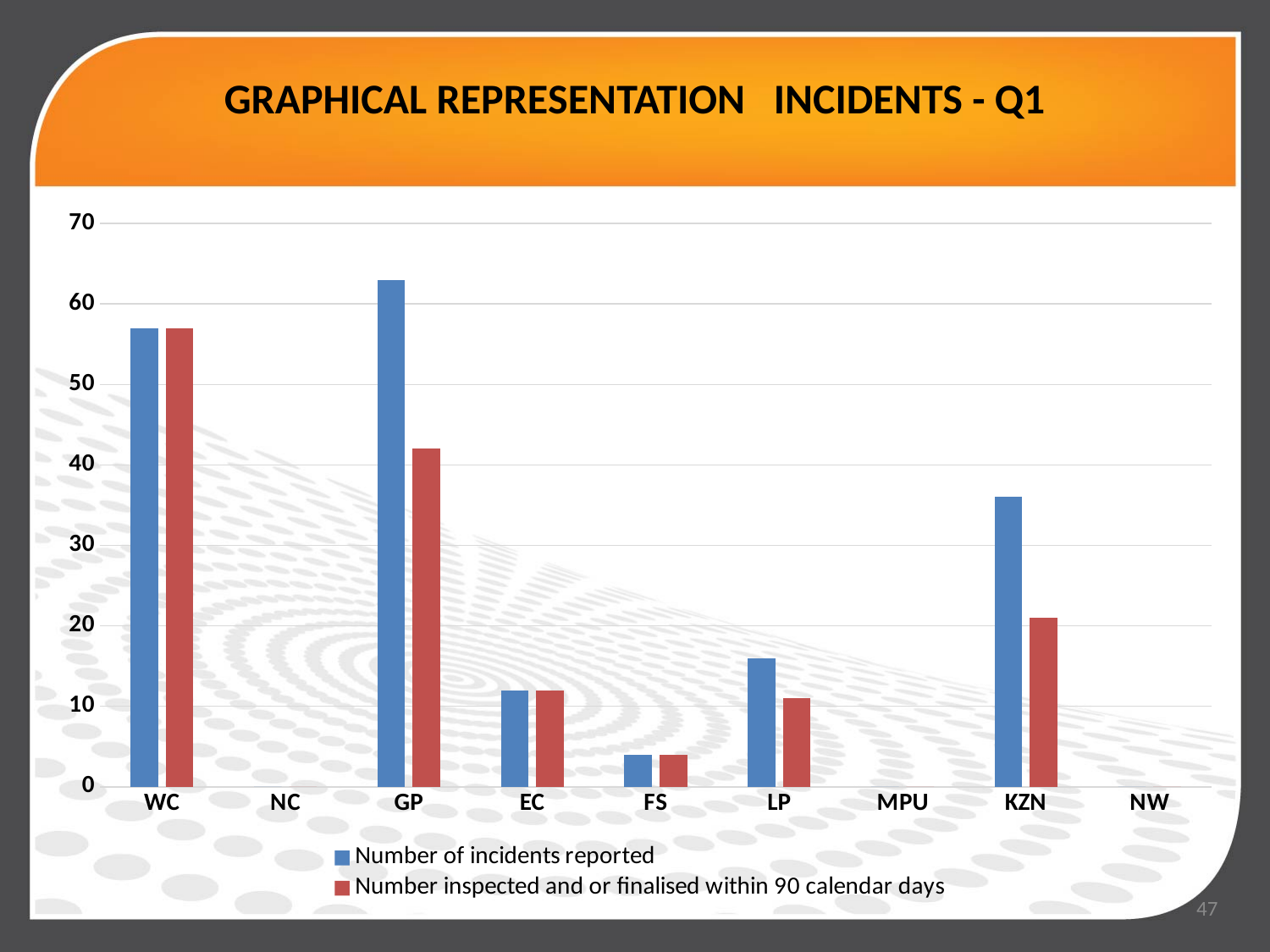
How many categories are shown on the x axis? 9 What is the title of the chart on the slide? GRAPHICAL REPRESENTATION INCIDENTS - Q1 What kind of chart is shown on the slide? bar chart Is the value for Number of incidents reported for GP greater or less than 60? greater Which category has the highest value for Number inspected and or finalised within 90 calendar days? WC Is the value for Number inspected and or finalised within 90 calendar days for GP greater or less than 50? less Which category has the larger value for Number of incidents reported, GP or KZN? GP How many series does the legend list? 2 Is the value for Number of incidents reported for FS greater or less than 10? less Which is larger for LP: Number of incidents reported or Number inspected and or finalised within 90 calendar days? Number of incidents reported Which category has the highest value for Number of incidents reported? GP